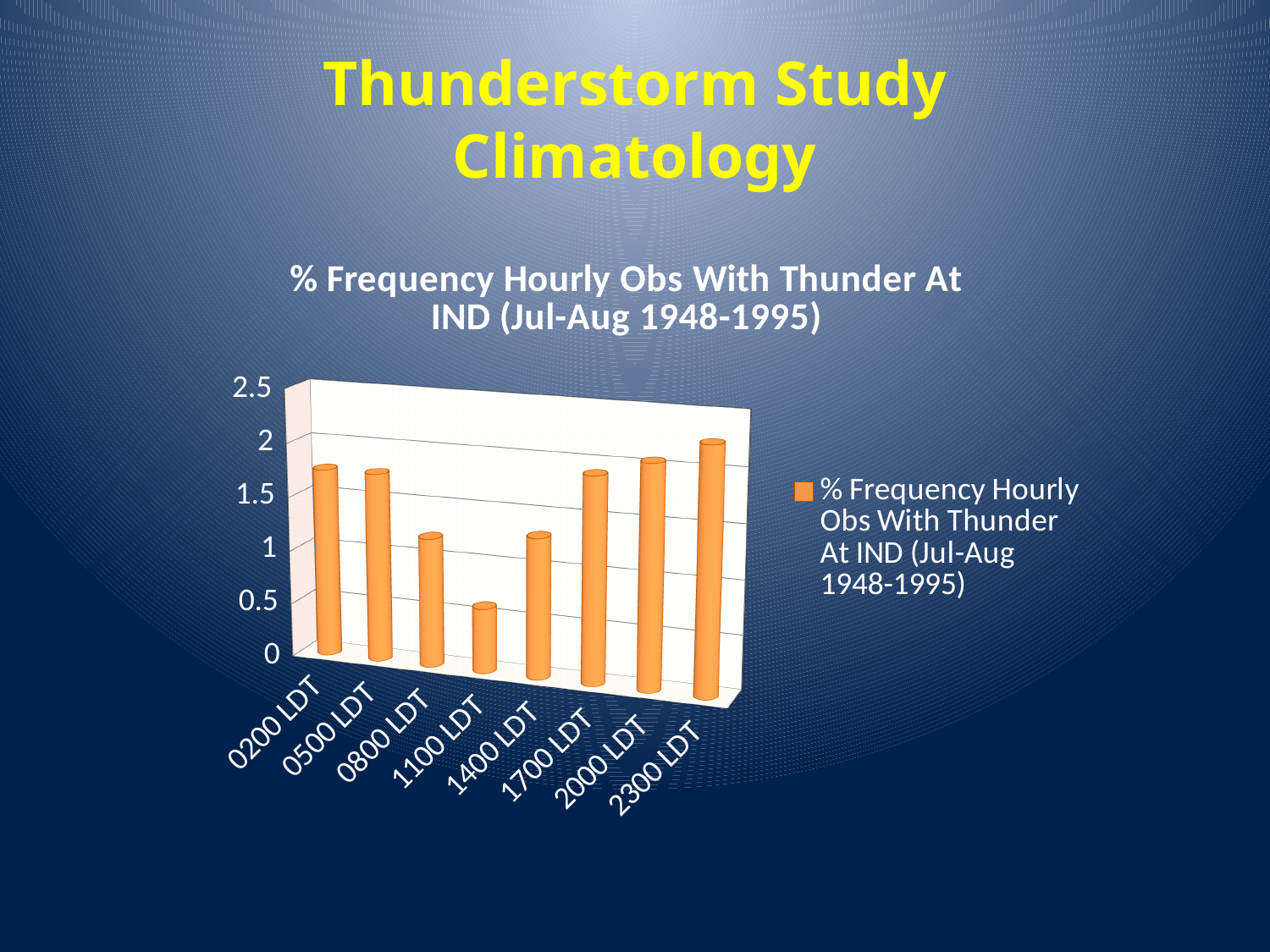
What is the title of the chart? % Frequency Hourly Obs With Thunder At IND (Jul-Aug 1948-1995) Is the value for 0200 LDT greater or less than 1? greater How many time categories are shown on the x axis of the chart? 8 What colour are the bars in the chart? orange Is the value for 1100 LDT greater or less than 1? less Is the value for 0800 LDT greater or less than 1.5? less Which has a larger value, 1100 LDT or 2300 LDT? 2300 LDT Which time category has the lowest % frequency of hourly obs with thunder? 1100 LDT How many series does the chart's legend list? 1 What kind of chart is shown on the slide? bar chart Which time category has the highest % frequency of hourly obs with thunder? 2300 LDT